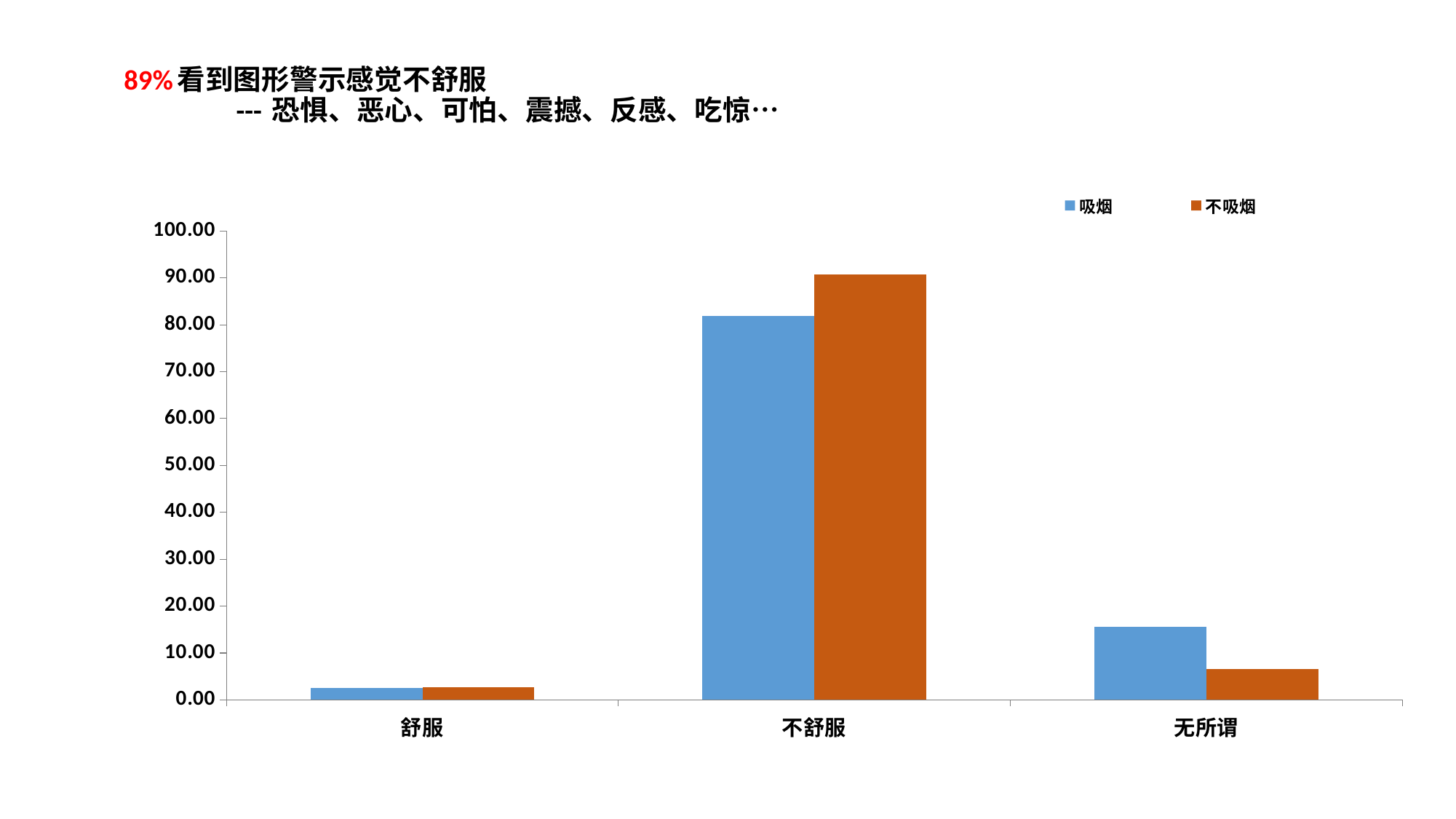
Which category has the highest value for the 吸烟 series? 不舒服 Which category has the lowest value for the 吸烟 series? 舒服 What kind of chart is shown on the slide? bar chart How many categories are shown on the x axis of the chart? 3 How many series does the chart's legend list? 2 For the 无所谓 category, which series has the larger value, 吸烟 or 不吸烟? 吸烟 Which category has the lowest value for the 不吸烟 series? 舒服 Which series is shown in orange in the chart's legend? 不吸烟 Which category has the highest value for the 不吸烟 series? 不舒服 Is the value for 吸烟 in the 无所谓 category greater or less than 20.00? less For the 不舒服 category, which series has the larger value, 吸烟 or 不吸烟? 不吸烟